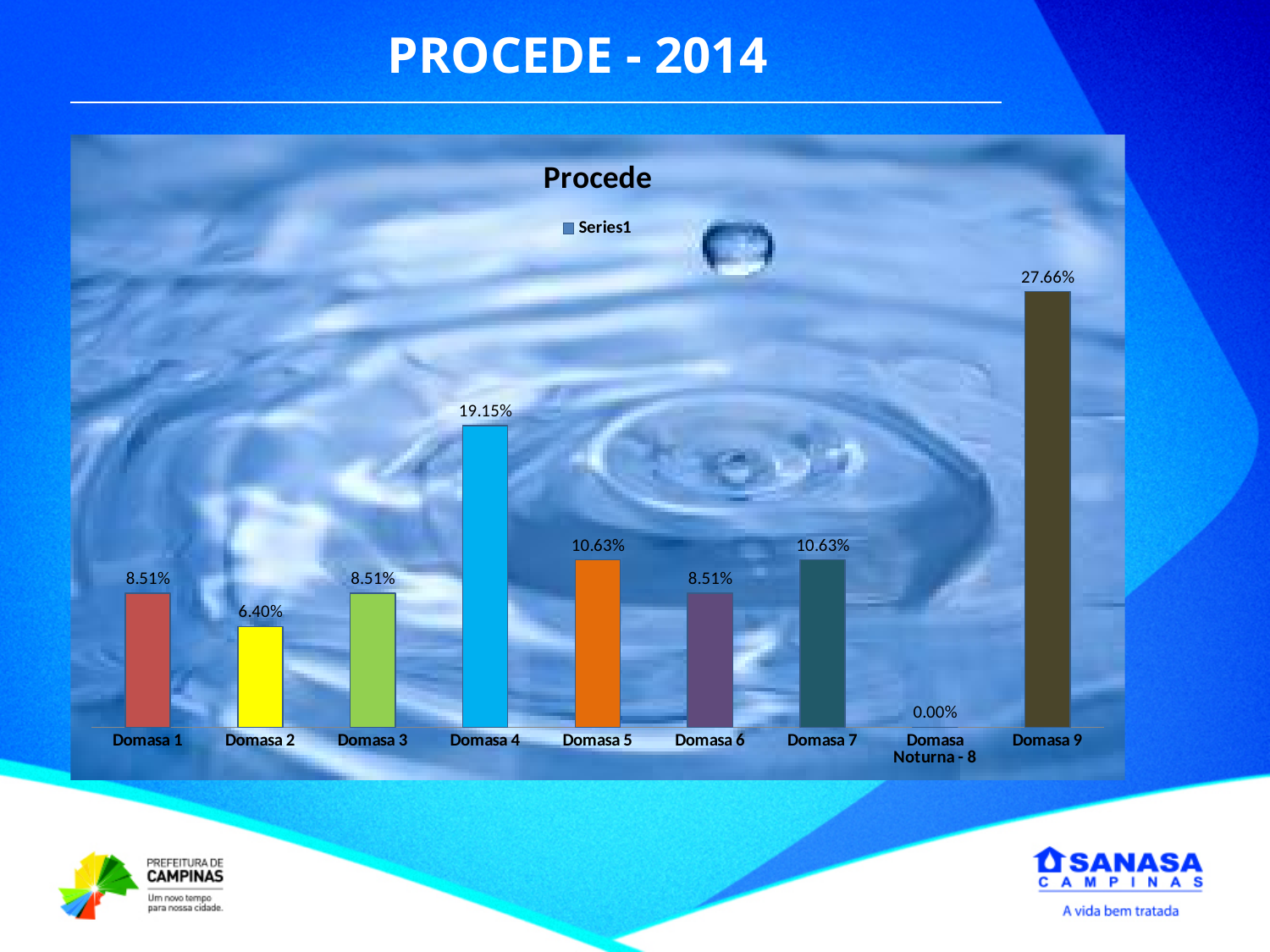
What is the difference between the values for Domasa 5 and Domasa 2? 4.23% Which is larger, the value for Domasa 7 or the value for Domasa 6? Domasa 7 How many series does the legend list? 1 What is the title of the chart? Procede Which category has the highest value? Domasa 9 What is the value for Domasa Noturna - 8? 0.00% What is the value for Domasa 4? 19.15% What is the value for Domasa 2? 6.40% Which category has the lowest value? Domasa Noturna - 8 What is the difference between the values for Domasa 9 and Domasa 4? 8.51% What kind of chart is shown? Bar chart How many categories are shown on the x axis? 9